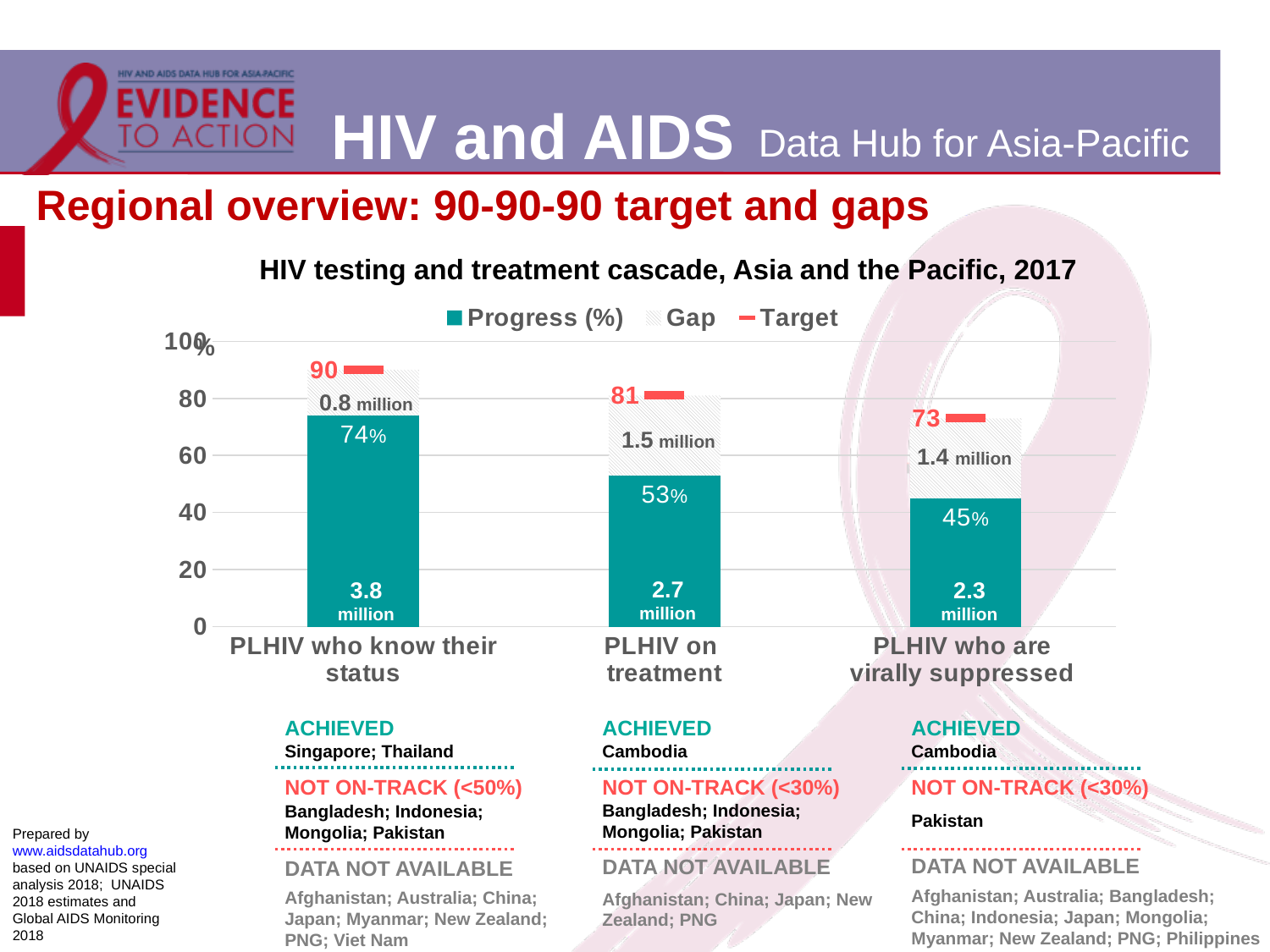
Do the progress percentages rise or fall from left to right across the categories? fall What is the difference in progress percentage between PLHIV who know their status and PLHIV on treatment? 21 percentage points What is the progress percentage for PLHIV who are virally suppressed? 45% How many entries does the legend list? 3 Is the progress percentage for PLHIV on treatment greater or less than 60? less What is the target value shown for PLHIV on treatment? 81 Which category has the highest progress percentage? PLHIV who know their status How many PLHIV know their status, according to the label on the bar? 3.8 million Which category has the lowest progress percentage? PLHIV who are virally suppressed What is the progress percentage for PLHIV on treatment? 53% What is the progress percentage for PLHIV who know their status? 74% What is the gap label shown for PLHIV who are virally suppressed? 1.4 million